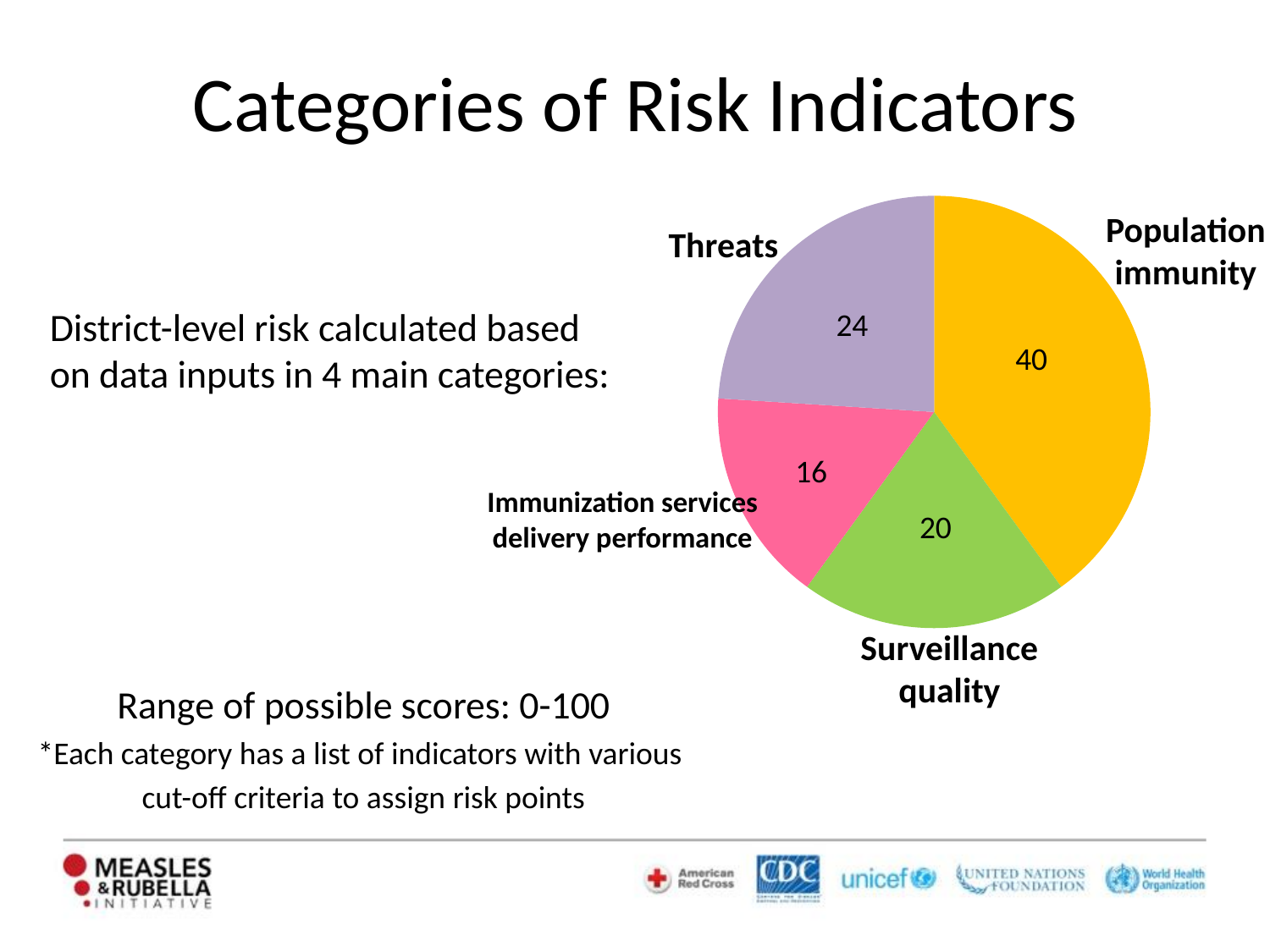
Which is larger, Surveillance quality or Immunization services delivery performance? Surveillance quality Which category has the smallest slice? Immunization services delivery performance What kind of chart is shown on the slide? Pie chart What is the value for Surveillance quality? 20 What is the value for Immunization services delivery performance? 16 Which category has the largest slice? Population immunity What is the value for Population immunity? 40 What is the difference between the values for Population immunity and Threats? 16 What colour is the Surveillance quality slice? Green What share of the pie does Population immunity represent? 40% How many categories are shown in the pie chart? 4 What is the value for Threats? 24